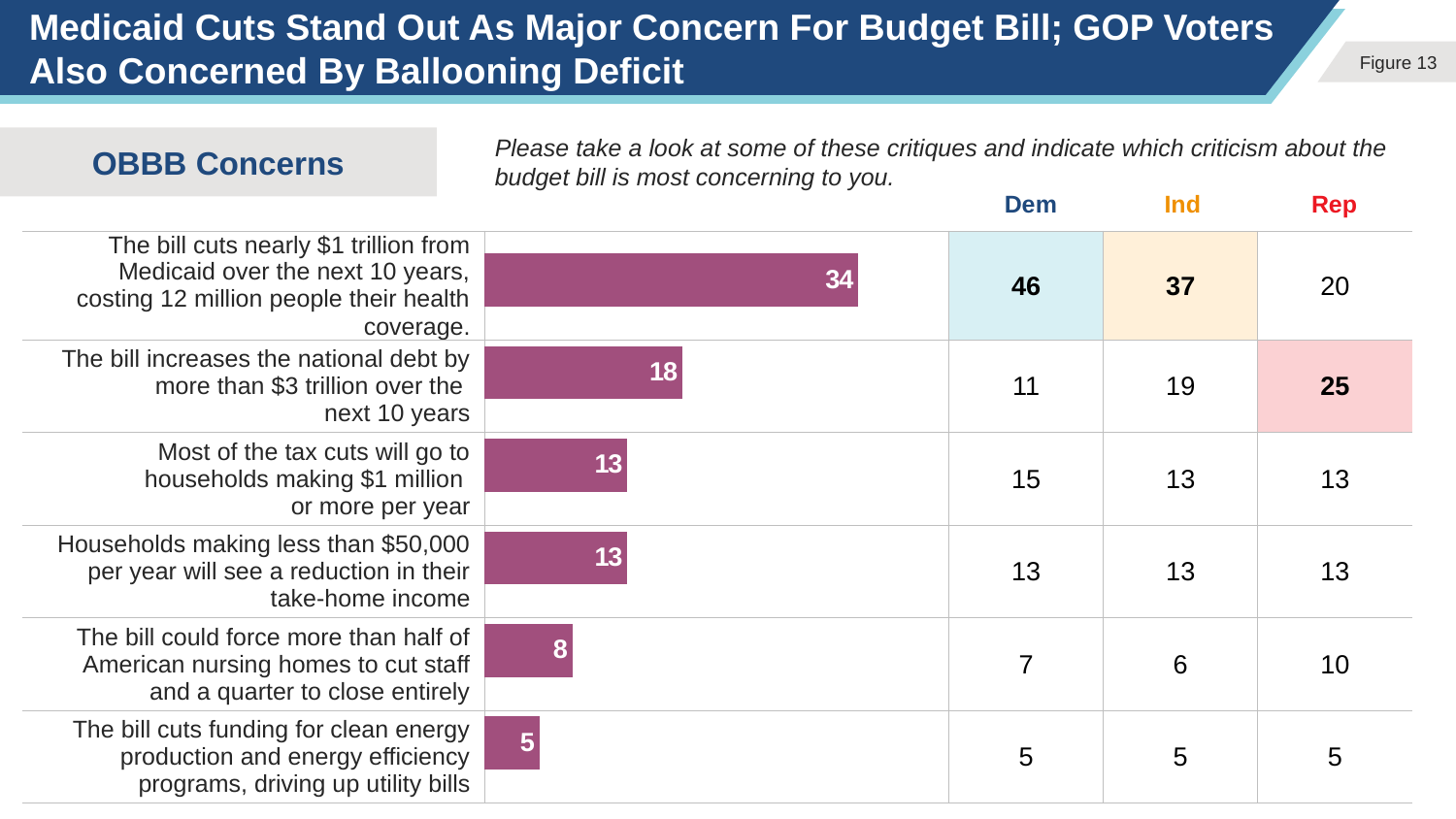
In the table next to the chart, what is the Dem value for the Medicaid cuts critique? 46 Which critique has the lowest bar value? The bill cuts funding for clean energy production and energy efficiency programs, driving up utility bills What kind of chart is shown on the slide? bar chart What is the value of the bar for "The bill could force more than half of American nursing homes to cut staff and a quarter to close entirely"? 8 What is the value of the bar for "The bill increases the national debt by more than $3 trillion over the next 10 years"? 18 Which critique has the highest bar value? The bill cuts nearly $1 trillion from Medicaid over the next 10 years, costing 12 million people their health coverage. In the table next to the chart, what is the Rep value for "The bill increases the national debt by more than $3 trillion over the next 10 years"? 25 What is the value of the bar for "The bill cuts nearly $1 trillion from Medicaid over the next 10 years, costing 12 million people their health coverage"? 34 What is the title shown in the box to the left of the chart? OBBB Concerns Which has a larger bar value: the national debt critique or the nursing homes critique? The national debt critique What is the difference between the bar value for the Medicaid cuts critique and the bar value for the national debt critique? 16 How many critiques (categories) are plotted in the bar chart? 6